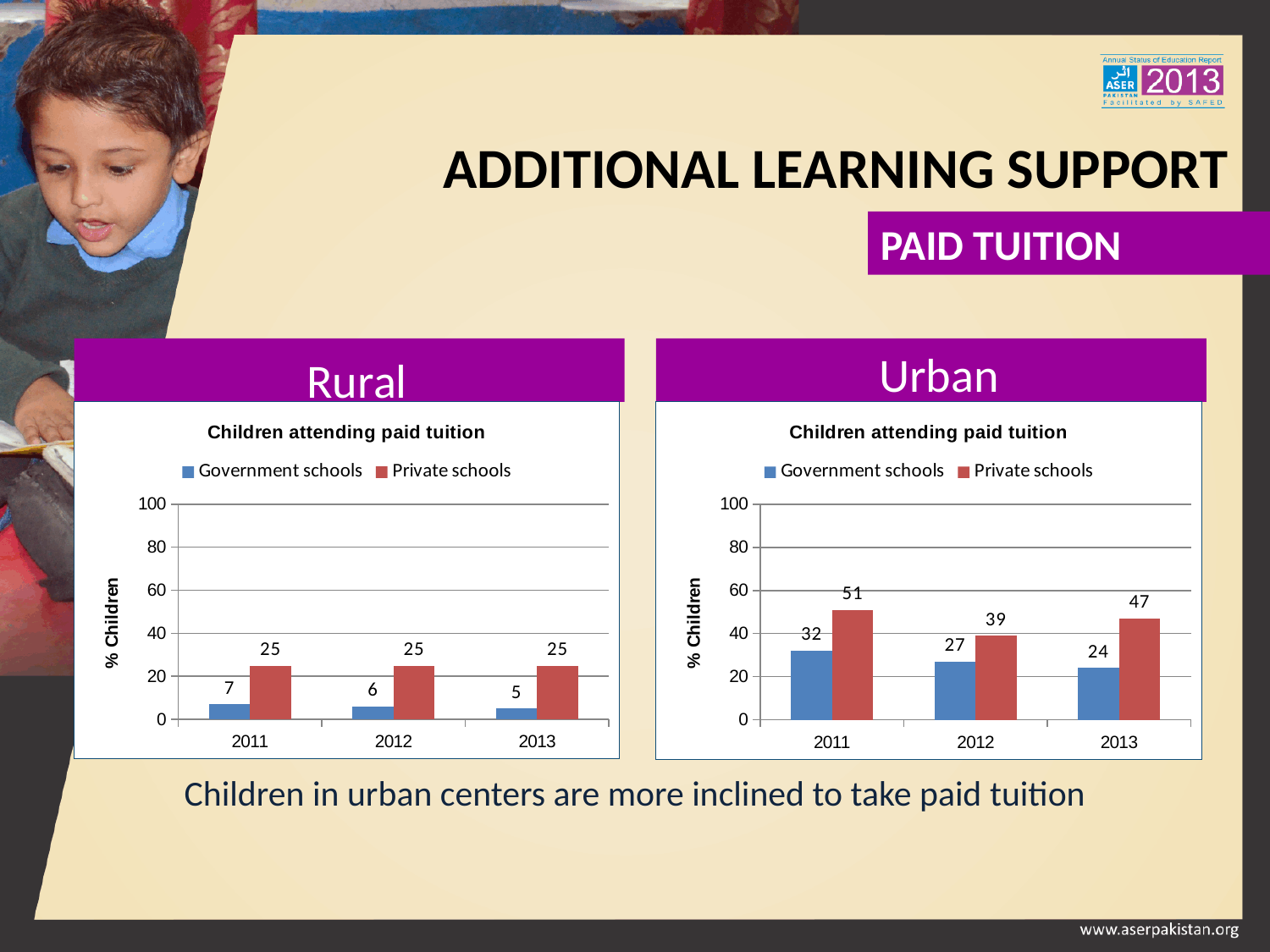
In the Urban chart, how many years are shown on the x axis? 3 In the Urban chart, do the Government schools values rise or fall from 2011 to 2013? Fall In the Rural chart, what is the value for Government schools in 2011? 7 In the Rural chart, how many series does the legend list? 2 In the Urban chart, what is the value for Government schools in 2013? 24 What type of chart is the Urban chart? Bar chart In the Urban chart, what is the value for Private schools in 2012? 39 In the Urban chart, which year has the highest value for Private schools? 2011 Which is larger: the Government schools value for 2012 in the Urban chart or the Private schools value for 2012 in the Rural chart? Urban Government schools 2012 In the Rural chart, what is the difference between Private schools and Government schools in 2013? 20 In the Urban chart, what is the difference between Private schools and Government schools in 2011? 19 In the Rural chart, which year has the lowest value for Government schools? 2013